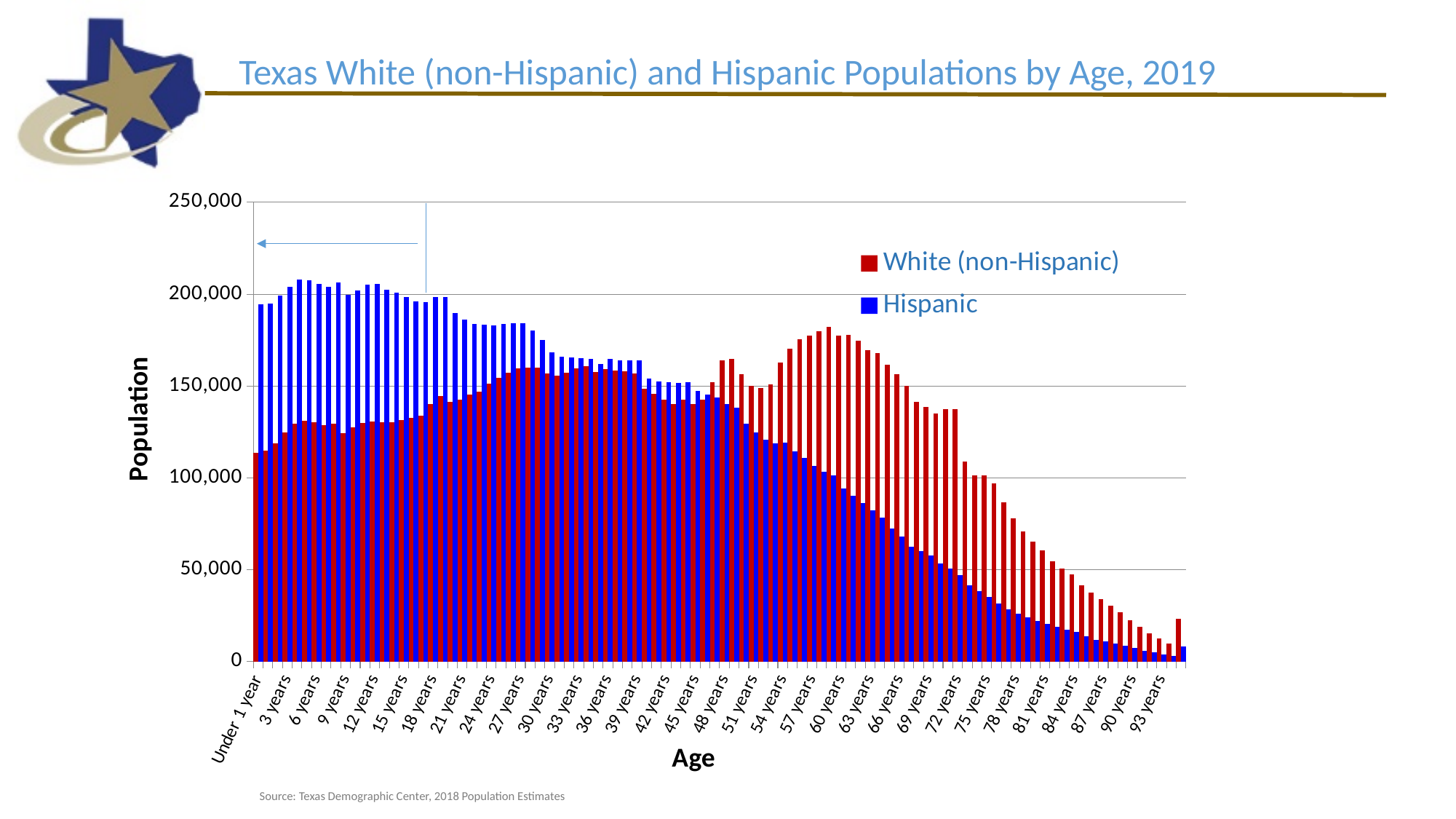
Do the Hispanic values generally rise or fall from 30 years to 93 years? fall How many series does the legend list? 2 At 60 years, which series has the larger value, White (non-Hispanic) or Hispanic? White (non-Hispanic) Is the White (non-Hispanic) value for Under 1 year greater or less than 150,000? less Is the Hispanic value for 75 years greater or less than 50,000? less Is the Hispanic value for Under 1 year greater or less than 150,000? greater What colour represents the Hispanic series in the legend? blue At Under 1 year, which series has the larger value, White (non-Hispanic) or Hispanic? Hispanic What kind of chart is shown on the slide? bar chart